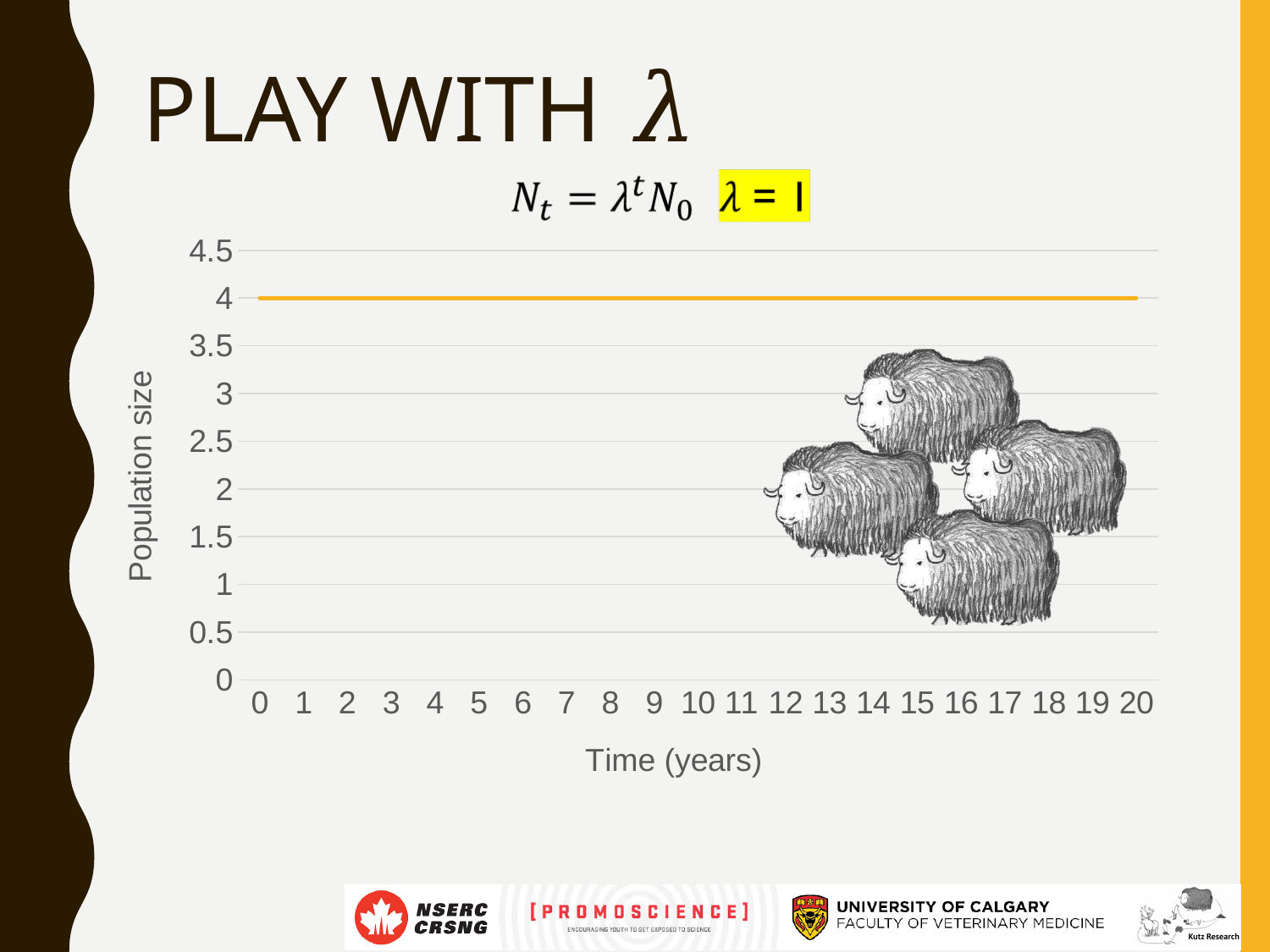
What is the label of the y axis? Population size What is the label of the x axis? Time (years) What is the population size at year 20? 4 What is the highest value shown on the y axis? 4.5 Does the population size rise, fall, or stay flat as time increases from year 0 to year 20? stays flat What is the last year shown on the x axis? 20 What is the population size at year 10? 4 Is the population size at year 5 greater or less than 3? greater Is the population size at year 15 greater or less than 4.5? less What is the difference between the population size at year 20 and at year 0? 0 What is the population size at year 0? 4 What kind of chart is shown on the slide? line chart